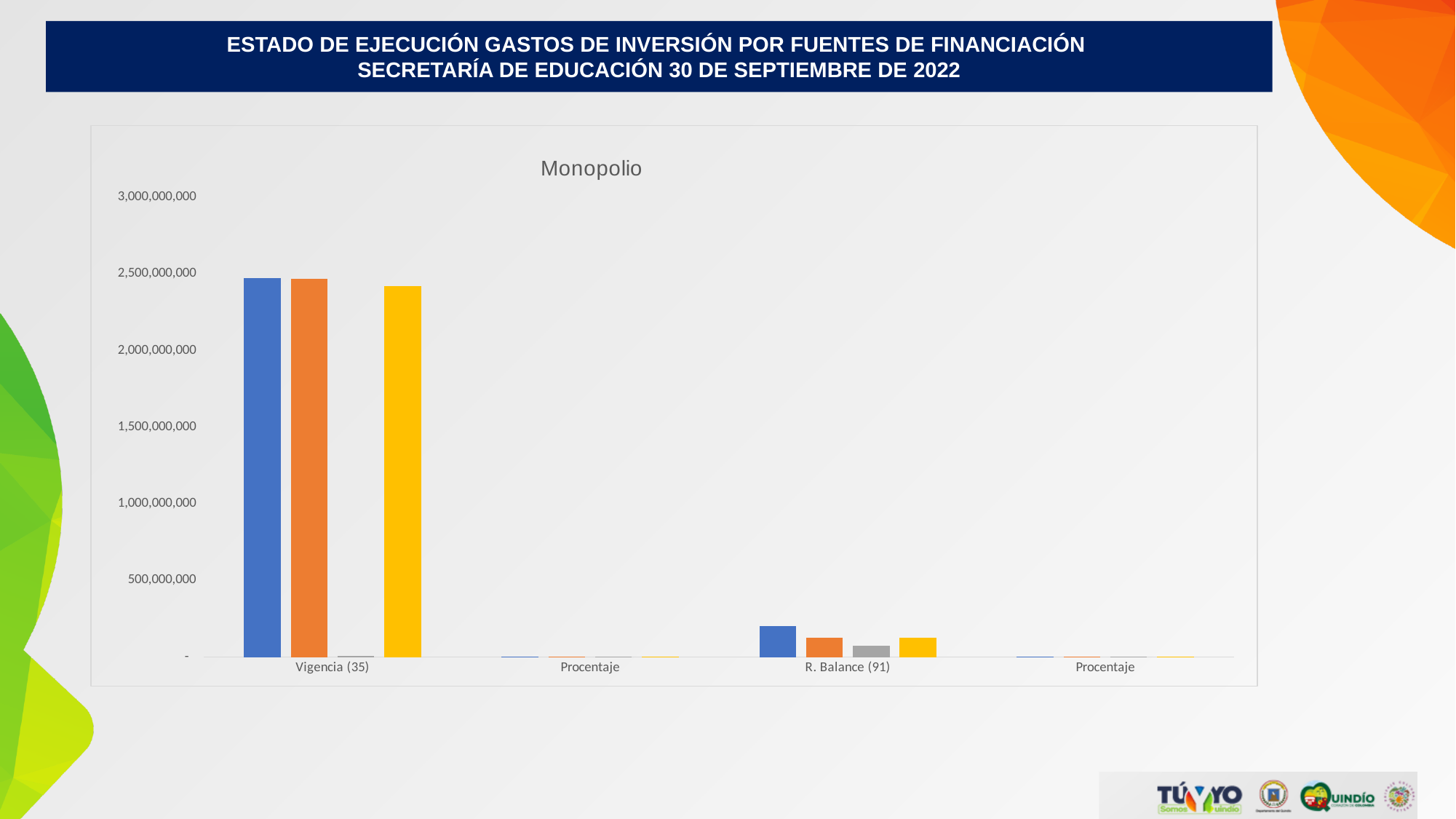
Which category in the Monopolio chart has the tallest bars? Vigencia (35) In the Monopolio chart, which is larger: the blue bar for Vigencia (35) or the blue bar for R. Balance (91)? Vigencia (35) In the Monopolio chart, is the value of the orange bar for Vigencia (35) greater or less than 1,500,000,000? greater In the Monopolio chart, is the value of the orange bar for R. Balance (91) greater or less than 500,000,000? less In the Monopolio chart, is the value of the blue bar for Vigencia (35) greater or less than 2,000,000,000? greater What kind of chart is shown under the title "Monopolio"? bar chart What is the title of the chart on the slide? Monopolio What is the highest value shown on the vertical axis of the Monopolio chart? 3,000,000,000 In the Monopolio chart, which is larger: the orange bar for Vigencia (35) or the orange bar for R. Balance (91)? Vigencia (35) How many categories are shown on the x axis of the Monopolio chart? 4